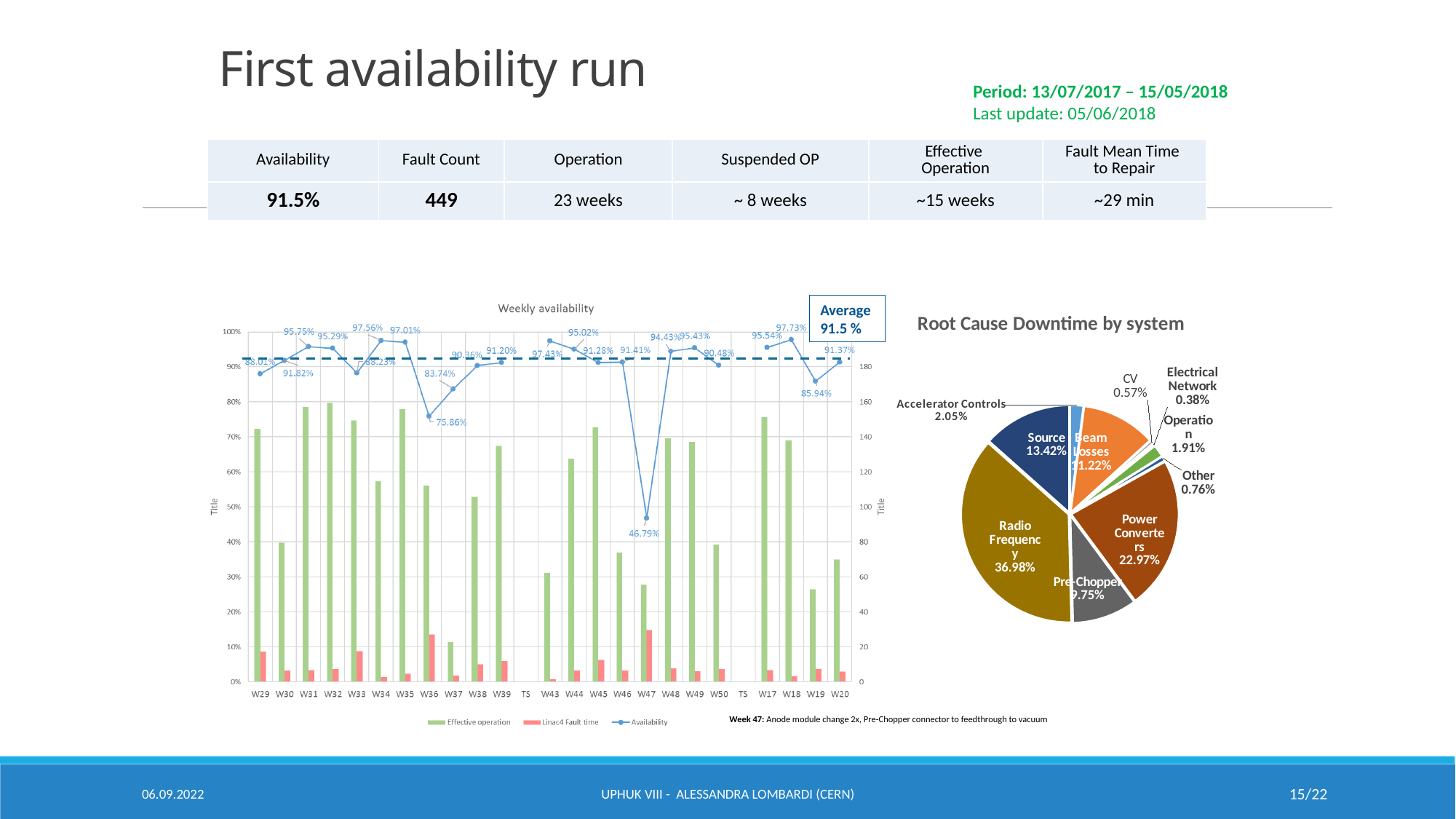
What kind of chart is the Weekly availability chart? Combined bar and line chart How many series does the legend of the Weekly availability chart list? 3 In the Weekly availability chart, what is the difference in availability between W48 and W47? 47.64 percentage points In the Root Cause Downtime by system pie chart, which system has the smallest share? Electrical Network In the Root Cause Downtime by system pie chart, how many percentage points larger is the Radio Frequency share than the Power Converters share? 14.01 percentage points How many slices does the Root Cause Downtime by system pie chart have? 10 In the Weekly availability chart, what is the availability value for W36? 75.86% In the Root Cause Downtime by system pie chart, which system accounts for the largest share of downtime? Radio Frequency In the Weekly availability chart, which week has the lowest availability? W47 In the Weekly availability chart, which week has the highest availability? W18 In the Weekly availability chart, which week has the higher availability, W31 or W32? W31 In the Root Cause Downtime by system pie chart, what share of downtime is attributed to Power Converters? 22.97%